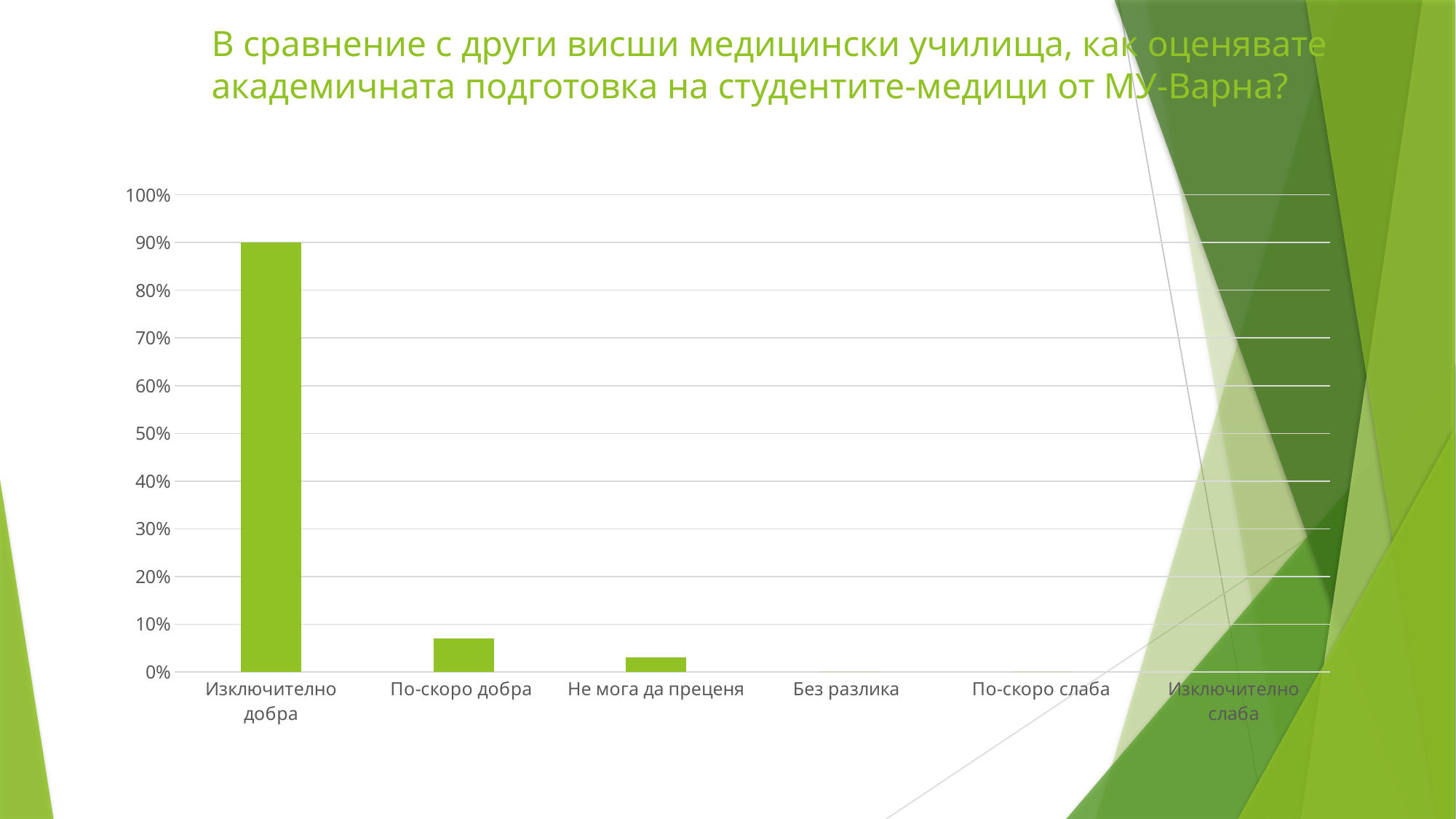
What is the value for Изключително добра? 90% What is the highest value shown on the vertical axis of the chart? 100% Is the value for По-скоро добра greater or less than 10%? less Is the value for Изключително добра greater or less than 80%? greater Is the value for Не мога да преценя greater or less than 10%? less Which is larger, the value for По-скоро добра or the value for Не мога да преценя? По-скоро добра Which category has the highest value in the chart? Изключително добра What colour are the bars in the chart? green Do the values rise or fall moving from left to right along the x axis? fall What kind of chart is shown on the slide? bar chart Which is larger, the value for Изключително добра or the value for По-скоро добра? Изключително добра How many categories are shown on the x axis of the chart? 6